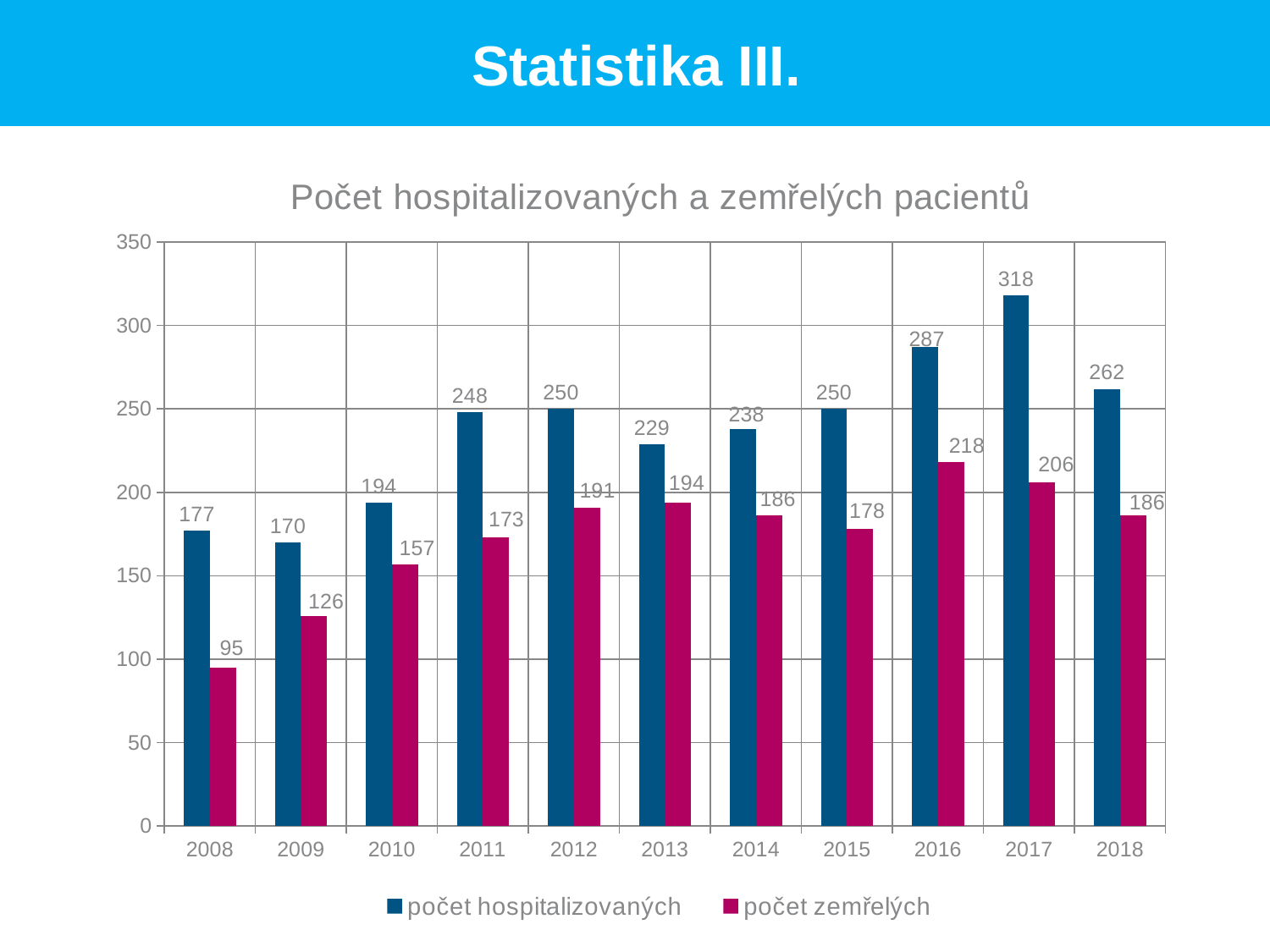
What is the difference between počet hospitalizovaných and počet zemřelých in 2018? 76 Which year has the lowest value for počet zemřelých? 2008 What kind of chart is shown on the slide? bar chart How many years are shown on the x axis? 11 How many series does the legend list? 2 What is the title of the chart? Počet hospitalizovaných a zemřelých pacientů Is the value of počet hospitalizovaných for 2016 greater or less than 250? greater Which is larger: počet zemřelých in 2013 or počet zemřelých in 2015? 2013 What is the value of počet zemřelých for 2008? 95 Which year has the highest value for počet hospitalizovaných? 2017 What is the value of počet zemřelých for 2016? 218 What is the value of počet hospitalizovaných for 2017? 318